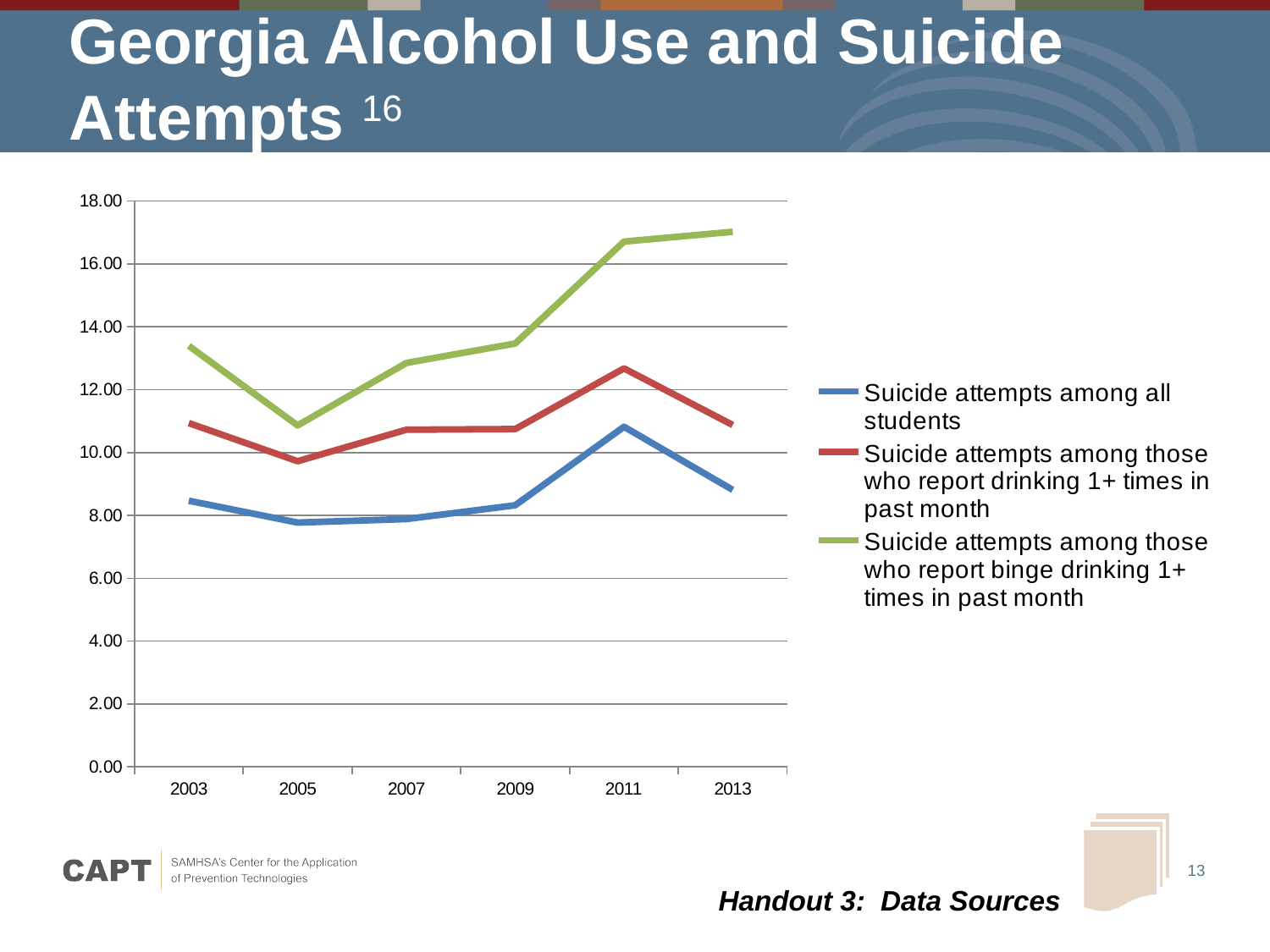
In which year is the value for suicide attempts among all students highest? 2011 In which year is the value for suicide attempts among those who report drinking 1+ times in past month highest? 2011 What colour is the line for suicide attempts among all students? blue In 2003, which is larger: suicide attempts among all students or suicide attempts among those who report binge drinking 1+ times in past month? Suicide attempts among those who report binge drinking 1+ times in past month How many years are plotted along the x axis? 6 Is the 2013 value for suicide attempts among those who report binge drinking 1+ times in past month greater or less than 16.00? greater How many series does the legend list? 3 Is the 2005 value for suicide attempts among all students greater or less than 8.00? less In which year is the value for suicide attempts among those who report binge drinking 1+ times in past month lowest? 2005 Does the line for suicide attempts among those who report binge drinking 1+ times in past month rise or fall from 2005 to 2013? rise What kind of chart is shown on the slide? line chart Is the 2011 value for suicide attempts among those who report drinking 1+ times in past month greater or less than 12.00? greater